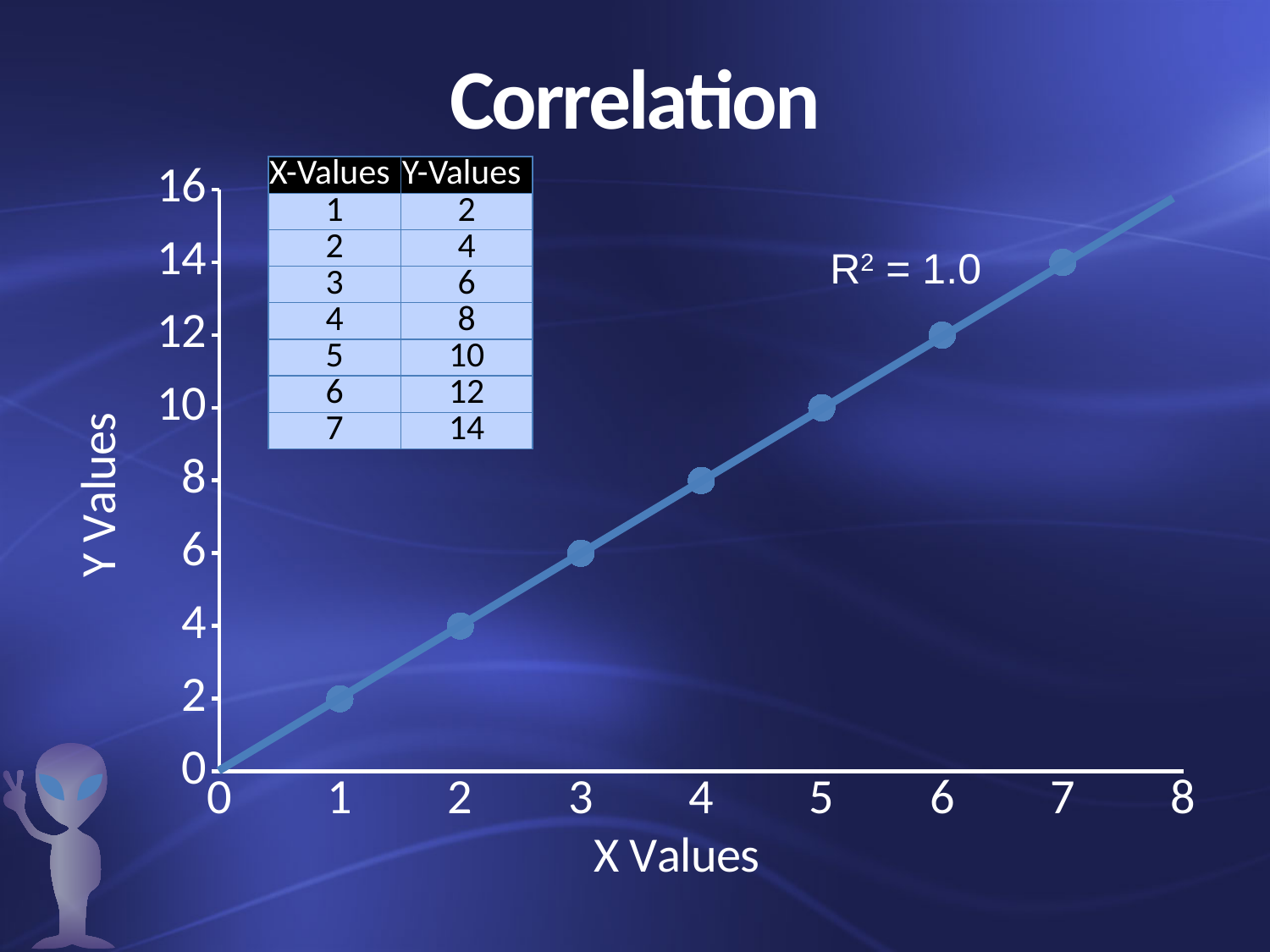
What is the Y value when X is 4? 8 Is the Y value at X = 6 greater or less than 10? greater Which is larger, the Y value at X = 3 or the Y value at X = 5? X = 5 Which X value has the lowest Y value? 1 What kind of chart is shown on the slide? Scatter chart What is the Y value when X is 1? 2 What R² value is shown on the chart? 1.0 What is the Y value when X is 7? 14 Which X value has the highest Y value? 7 What is the difference between the Y value at X = 6 and the Y value at X = 2? 8 Do the Y values rise or fall as the X values increase? Rise How many data points are plotted on the chart? 7